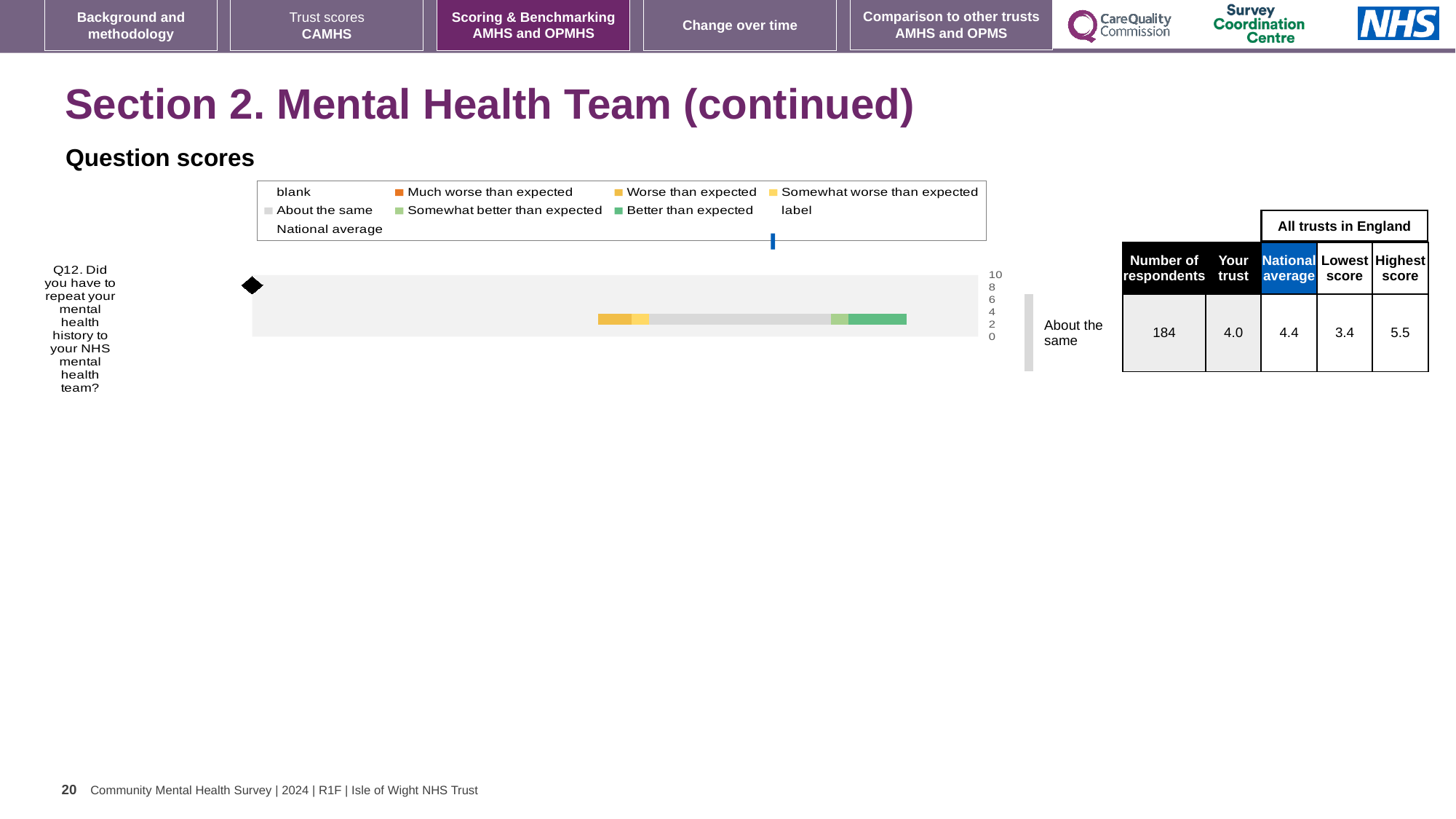
What is the difference between the national average and the 'Your trust' score for Q12? 0.4 How many survey questions are plotted in the chart? 1 In the table next to the chart, what is the highest score among all trusts in England for Q12? 5.5 In the table next to the chart, what is the national average score for Q12? 4.4 What is the difference between the highest score and the lowest score for Q12 in the table? 2.1 In the table next to the chart, what is the lowest score among all trusts in England for Q12? 3.4 What kind of chart is shown under 'Question scores'? bar chart In the table next to the chart, what is the 'Your trust' score for Q12? 4.0 Which question is plotted in the chart? Q12. Did you have to repeat your mental health history to your NHS mental health team? In the table next to the chart, what is the number of respondents for Q12? 184 What benchmark category label is shown to the right of the bar for Q12? About the same Is the 'Your trust' score for Q12 higher or lower than the national average? lower